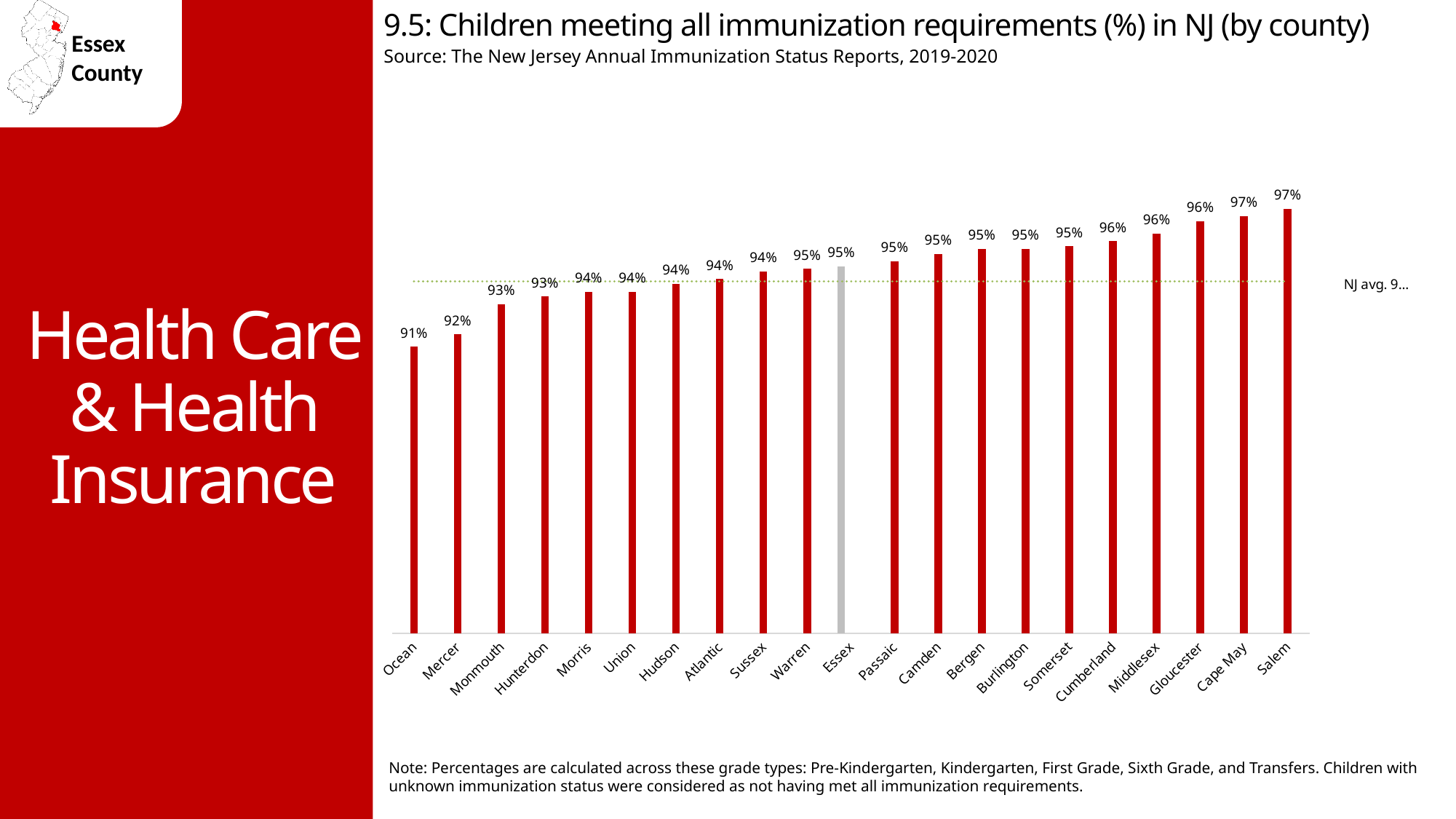
What kind of chart is shown on the slide? Bar chart What is the value shown for Ocean County? 91% How many counties are shown on the chart? 21 What is the value shown for Salem County? 97% Which county has the lowest percentage of children meeting all immunization requirements? Ocean What percentage of children in Essex County met all immunization requirements? 95% Do the values rise or fall moving from left to right along the x axis? Rise What is the value shown for Monmouth County? 93% What is the difference in percentage points between Essex and Mercer? 3 percentage points Which county's bar is coloured grey instead of red? Essex What is the difference in percentage points between Salem and Ocean? 6 percentage points Which has a higher value, Essex or Hunterdon? Essex